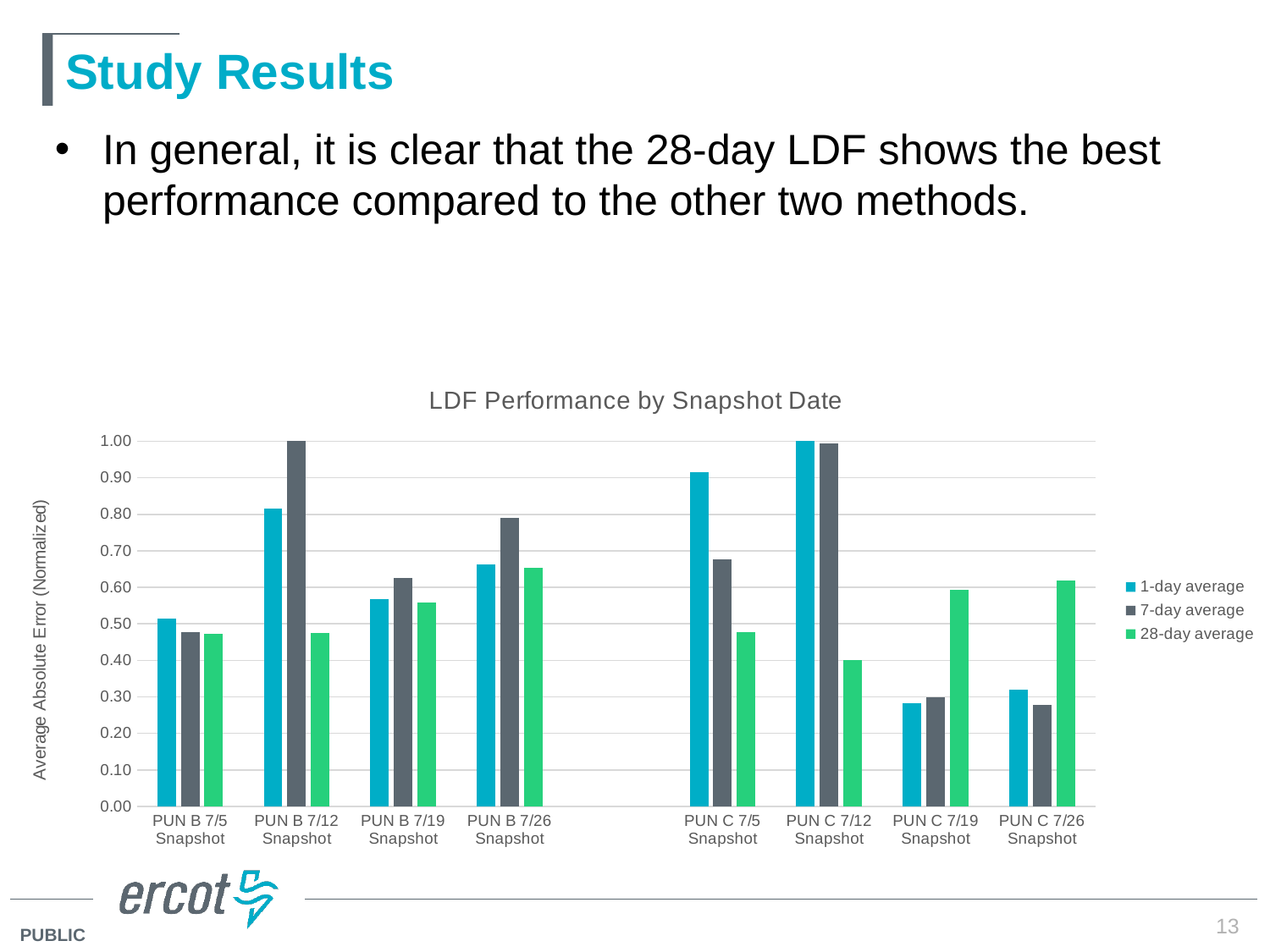
Is the 7-day average value for PUN B 7/26 Snapshot greater or less than 0.70? greater How many series does the legend list? 3 Which snapshot has the lowest 28-day average value? PUN C 7/12 Snapshot Is the 28-day average value for PUN C 7/12 Snapshot greater or less than 0.50? less How many snapshot categories are shown along the x axis? 8 For PUN B 7/12 Snapshot, which is larger: the 7-day average or the 28-day average? 7-day average What type of chart is shown on the slide? bar chart Is the 7-day average value for PUN B 7/12 Snapshot greater or less than 0.90? greater What is the label on the vertical axis of the chart? Average Absolute Error (Normalized) For PUN C 7/19 Snapshot, which is larger: the 1-day average or the 28-day average? 28-day average What is the title of the chart? LDF Performance by Snapshot Date